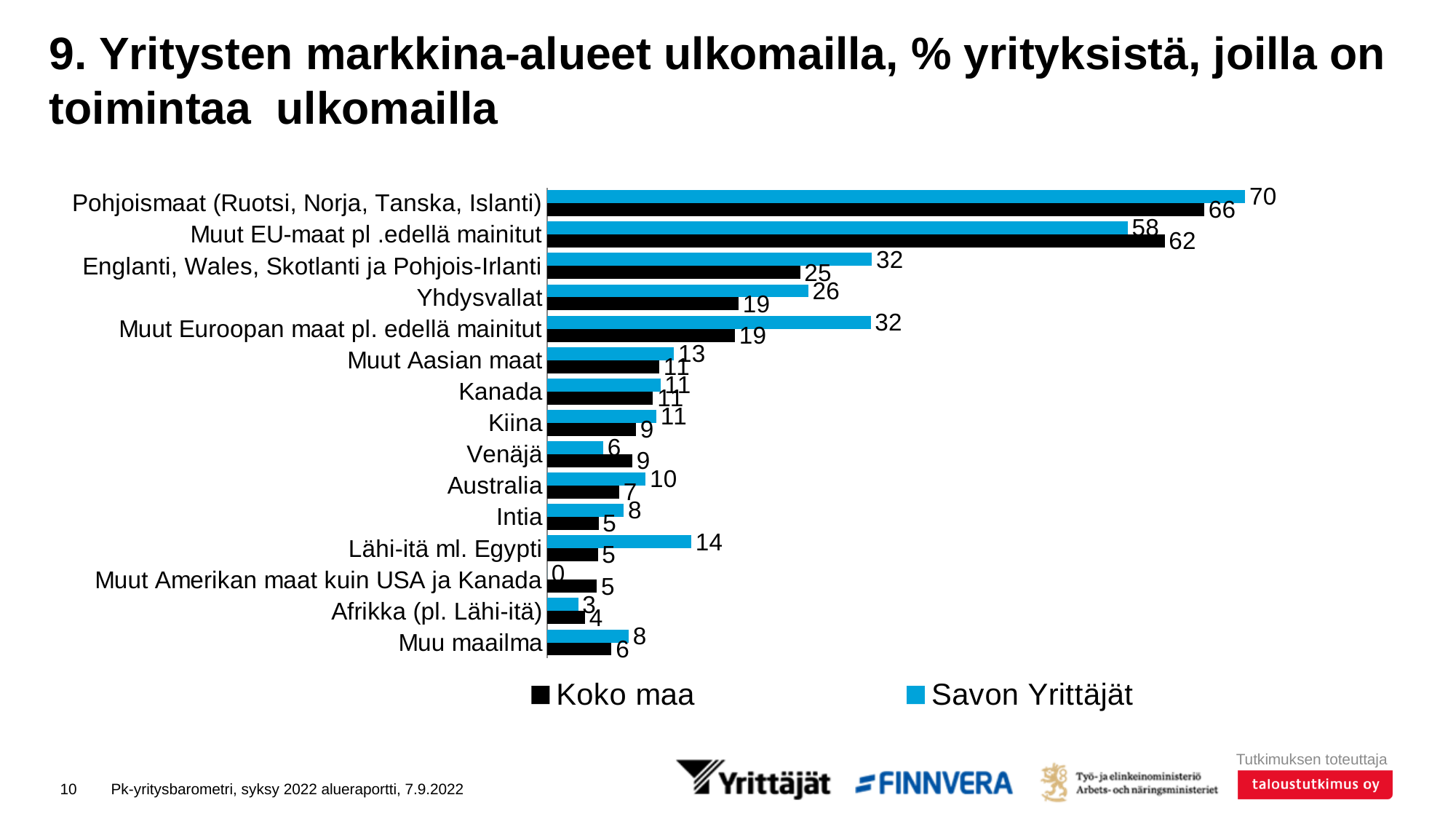
How many categories are shown on the chart? 15 What is the value for Savon Yrittäjät for Lähi-itä ml. Egypti? 14 For Englanti, Wales, Skotlanti ja Pohjois-Irlanti, which series has the larger value, Koko maa or Savon Yrittäjät? Savon Yrittäjät Which category has the lowest value for Savon Yrittäjät? Muut Amerikan maat kuin USA ja Kanada How many series does the legend list? 2 What kind of chart is shown on the slide? Bar chart What is the value for Koko maa for Muut EU-maat pl. edellä mainitut? 62 What is the difference between the Savon Yrittäjät and Koko maa values for Yhdysvallat? 7 For Venäjä, which series has the larger value, Koko maa or Savon Yrittäjät? Koko maa Which category has the highest value for Koko maa? Pohjoismaat (Ruotsi, Norja, Tanska, Islanti) What is the value for Savon Yrittäjät for Pohjoismaat (Ruotsi, Norja, Tanska, Islanti)? 70 What is the difference between the Savon Yrittäjät and Koko maa values for Muut Euroopan maat pl. edellä mainitut? 13